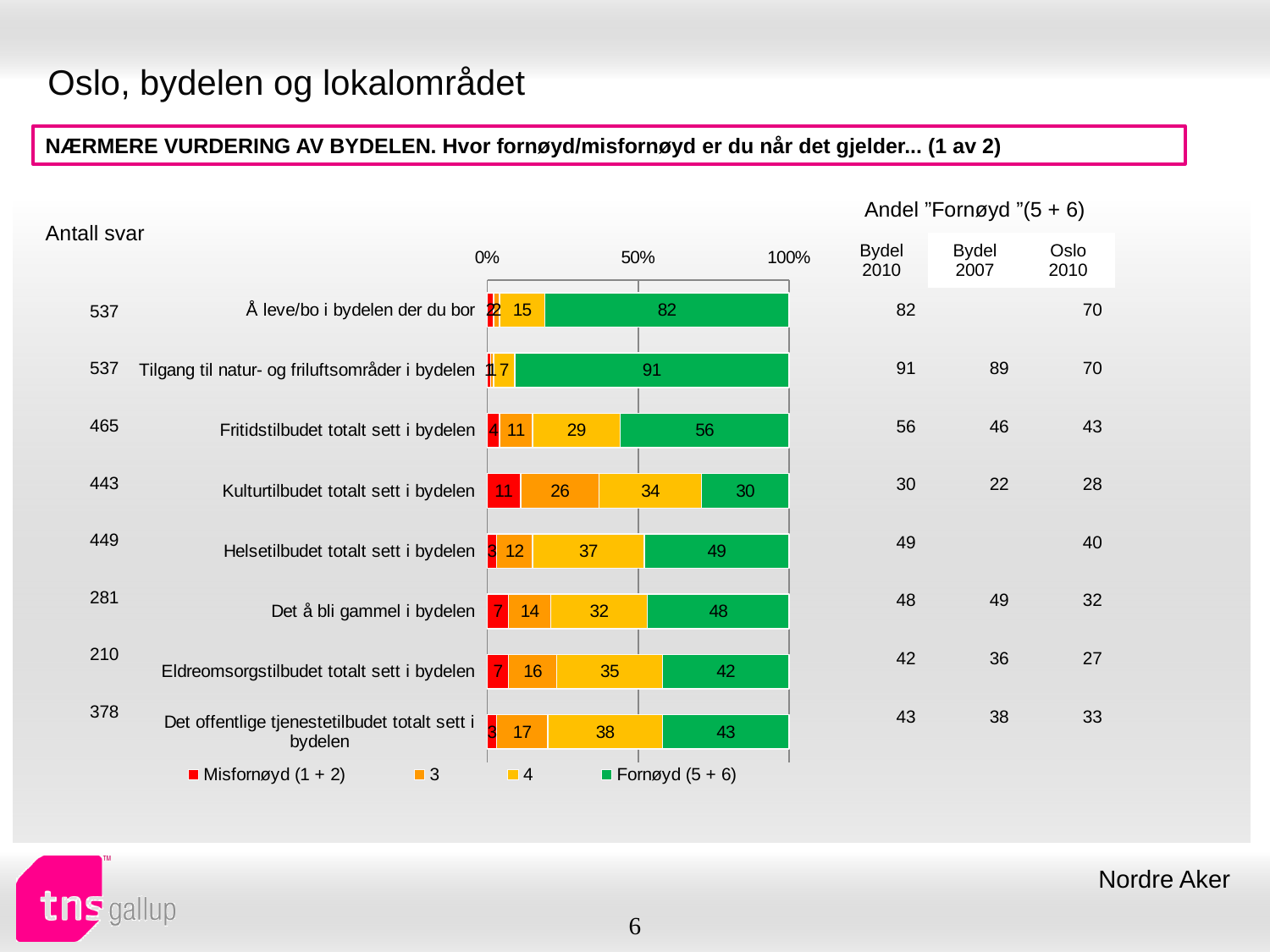
How many categories are plotted in the chart? 8 What is the first entry in the chart legend? Misfornøyd (1 + 2) What is the difference between the "Fornøyd (5 + 6)" values for "Fritidstilbudet totalt sett i bydelen" and "Kulturtilbudet totalt sett i bydelen"? 26 What kind of chart is shown on the slide? Stacked bar chart What is the value of the "4" segment for "Helsetilbudet totalt sett i bydelen"? 37 How many series does the legend list? 4 What is the value of the "Fornøyd (5 + 6)" segment for "Tilgang til natur- og friluftsområder i bydelen"? 91 Which has the larger "Fornøyd (5 + 6)" value: "Det å bli gammel i bydelen" or "Eldreomsorgstilbudet totalt sett i bydelen"? Det å bli gammel i bydelen What is the value of the "Misfornøyd (1 + 2)" segment for "Kulturtilbudet totalt sett i bydelen"? 11 What is the value of the "3" segment for "Kulturtilbudet totalt sett i bydelen"? 26 Which category has the lowest "Fornøyd (5 + 6)" value? Kulturtilbudet totalt sett i bydelen Which category has the highest "Fornøyd (5 + 6)" value? Tilgang til natur- og friluftsområder i bydelen